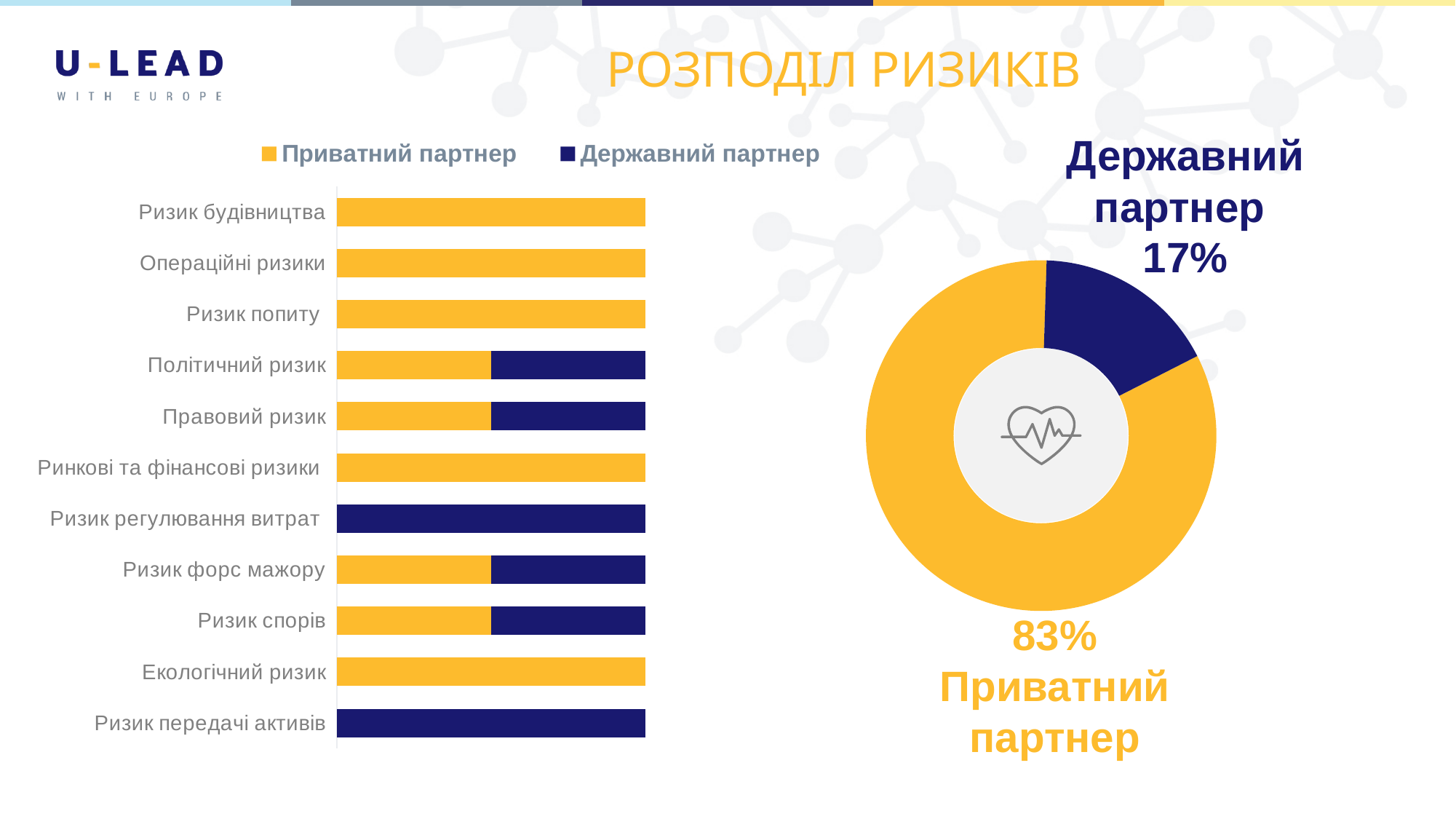
What kind of chart is the chart on the right side of the slide? Doughnut chart How many series does the legend of the bar chart on the left list? 2 In the doughnut chart on the right, which partner has the larger share? Приватний партнер In the doughnut chart on the right, what is the difference in percentage points between Приватний партнер and Державний партнер? 66 percentage points In the bar chart on the left, which partner is shown as bearing the entire bar for Ризик будівництва? Приватний партнер How many risk categories are listed in the bar chart on the left? 11 What are the two series named in the legend of the bar chart on the left? Приватний партнер and Державний партнер What kind of chart is the chart on the left side of the slide? Bar chart In the bar chart on the left, which partner is shown as bearing the entire bar for Ризик передачі активів? Державний партнер In the doughnut chart on the right, what share is shown for Державний партнер? 17% How many slices does the doughnut chart on the right have? 2 In the doughnut chart on the right, what share is shown for Приватний партнер? 83%